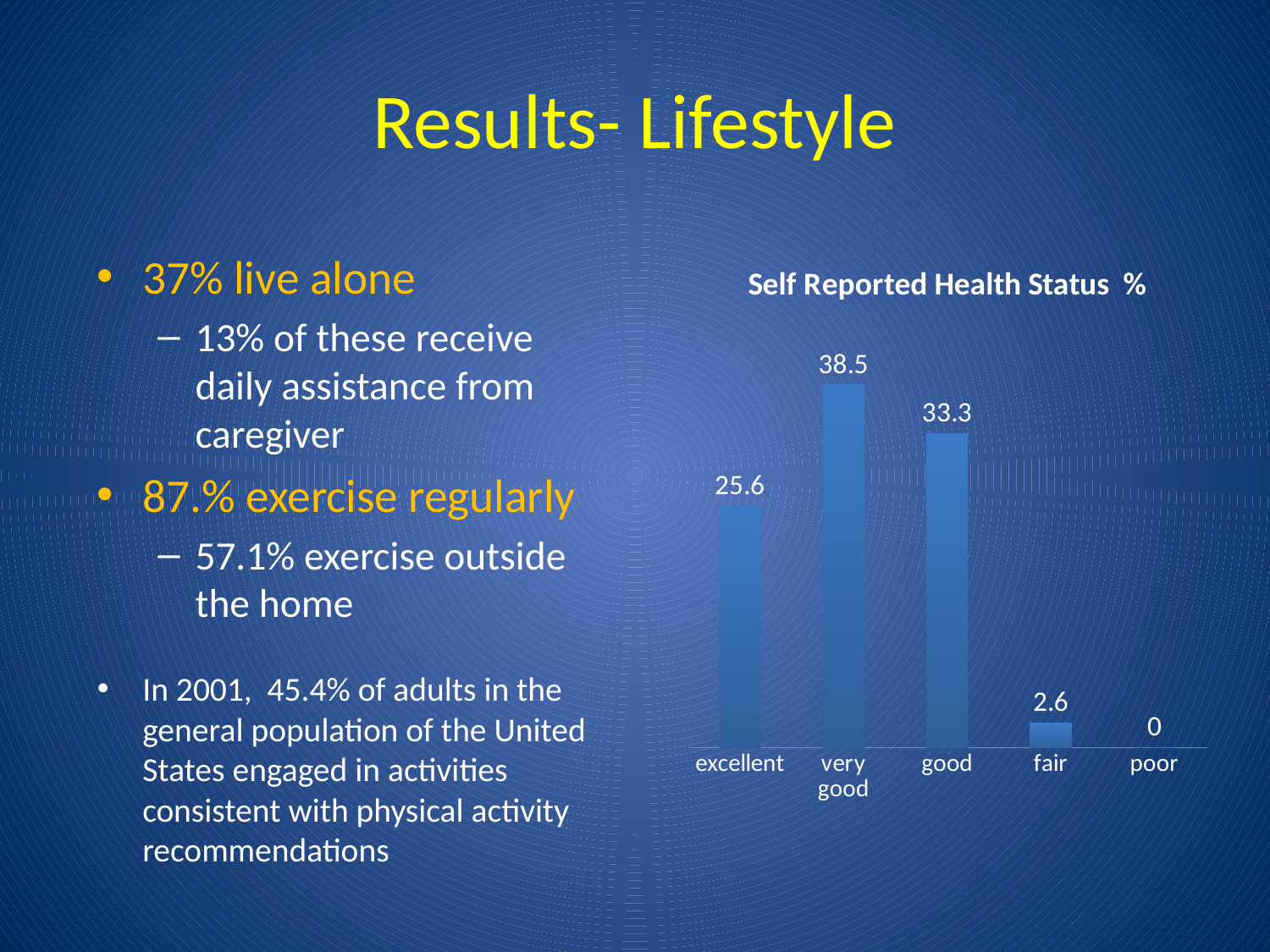
Which category has the lowest value in the Self Reported Health Status chart? poor How many categories are shown in the Self Reported Health Status chart? 5 What is the title of the chart on the slide? Self Reported Health Status % What is the value for 'very good' in the Self Reported Health Status chart? 38.5 What is the value for 'excellent' in the Self Reported Health Status chart? 25.6 What is the difference between the values for 'good' and 'excellent' in the Self Reported Health Status chart? 7.7 What is the value for 'poor' in the Self Reported Health Status chart? 0 Which is larger in the Self Reported Health Status chart, the value for 'good' or the value for 'excellent'? good Which category has the highest value in the Self Reported Health Status chart? very good What is the value for 'fair' in the Self Reported Health Status chart? 2.6 What kind of chart is the Self Reported Health Status chart? bar chart What is the difference between the values for 'very good' and 'good' in the Self Reported Health Status chart? 5.2